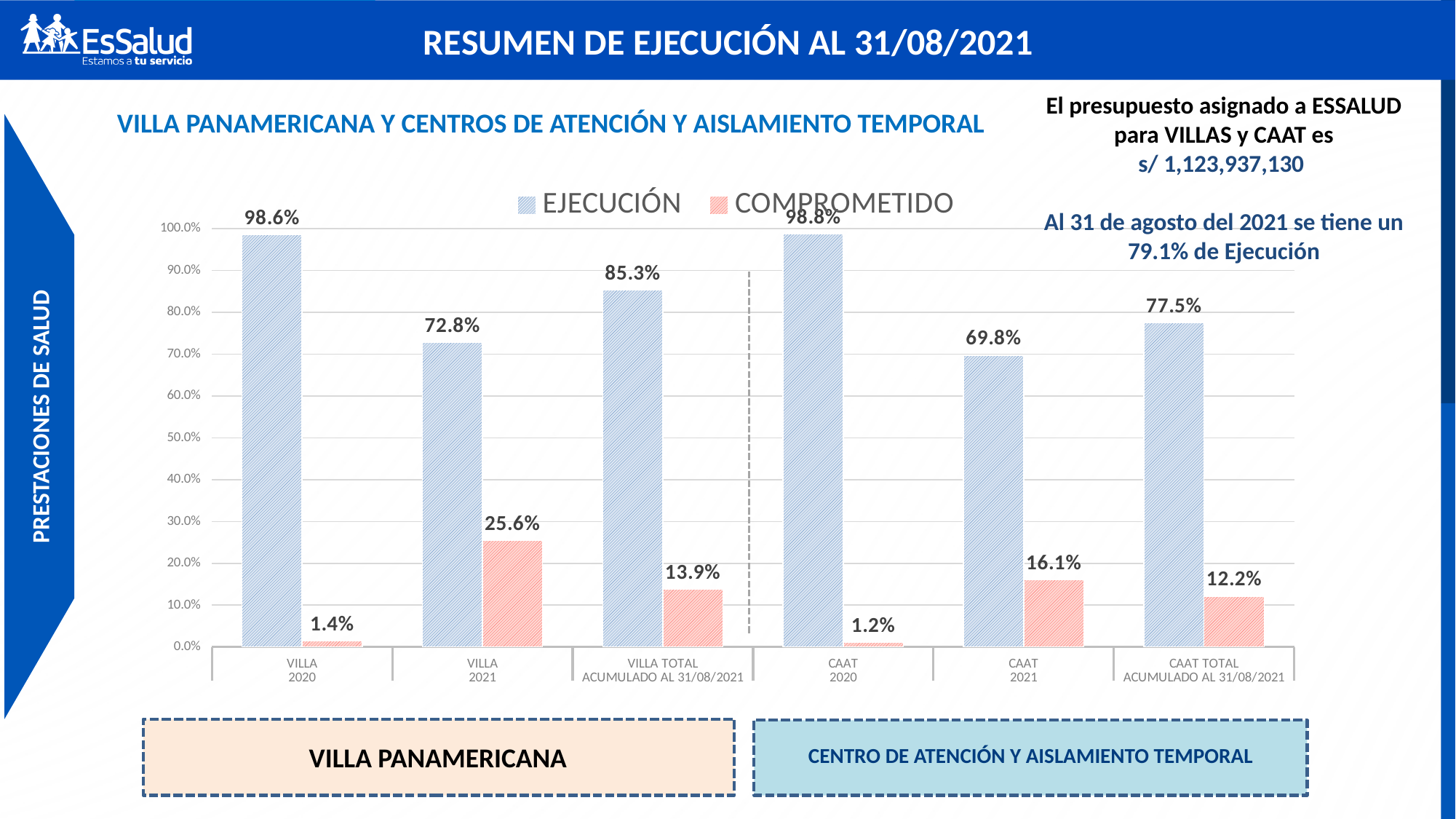
What is the difference between the EJECUCIÓN values for VILLA TOTAL ACUMULADO AL 31/08/2021 and CAAT TOTAL ACUMULADO AL 31/08/2021? 7.8 percentage points What is the EJECUCIÓN value for CAAT TOTAL ACUMULADO AL 31/08/2021? 77.5% How many series does the legend list? 2 What is the COMPROMETIDO value for VILLA 2021? 25.6% Is the EJECUCIÓN value for CAAT 2021 greater or less than 60.0%? greater Which category has the lowest EJECUCIÓN value? CAAT 2021 What is the EJECUCIÓN value for VILLA 2020? 98.6% What is the COMPROMETIDO value for CAAT 2020? 1.2% What is the difference between the EJECUCIÓN and COMPROMETIDO values for VILLA 2021? 47.2 percentage points Which category has the highest COMPROMETIDO value? VILLA 2021 Which is larger, the COMPROMETIDO value for VILLA 2021 or for CAAT 2021? VILLA 2021 How many categories are shown on the x axis of the chart? 6